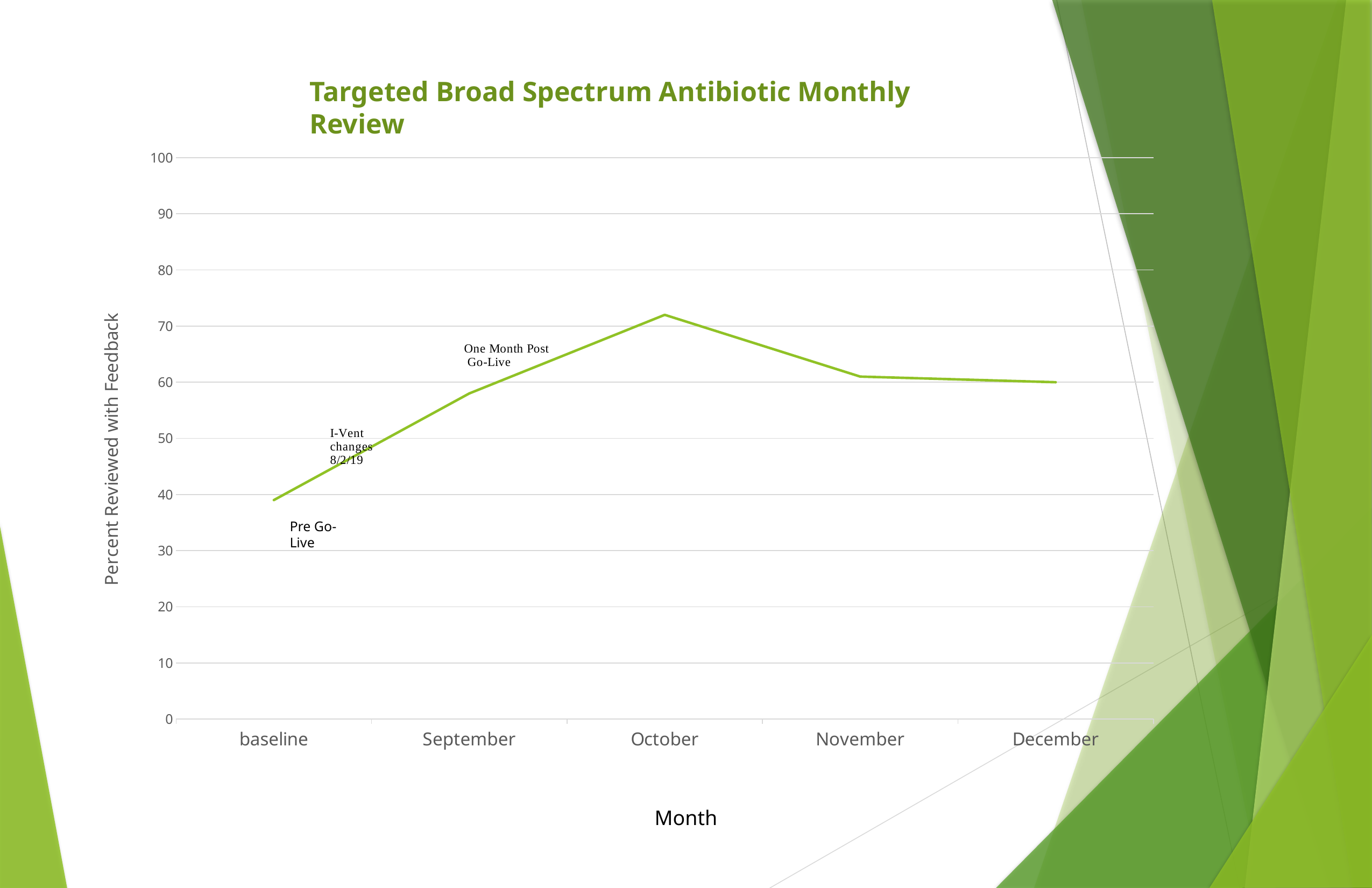
How many points are plotted along the x axis of the chart? 5 Which category has the lowest percent reviewed with feedback? baseline What kind of chart is shown on the slide? line chart Is the value for baseline greater or less than 30? greater What is the label on the vertical axis of the chart? Percent Reviewed with Feedback Is the value for December greater or less than 70? less Is the value for October greater or less than 60? greater Do the values rise or fall from baseline to October? rise Which is larger, the value for baseline or the value for December? December Which month has the highest percent reviewed with feedback? October What is the title of the chart? Targeted Broad Spectrum Antibiotic Monthly Review